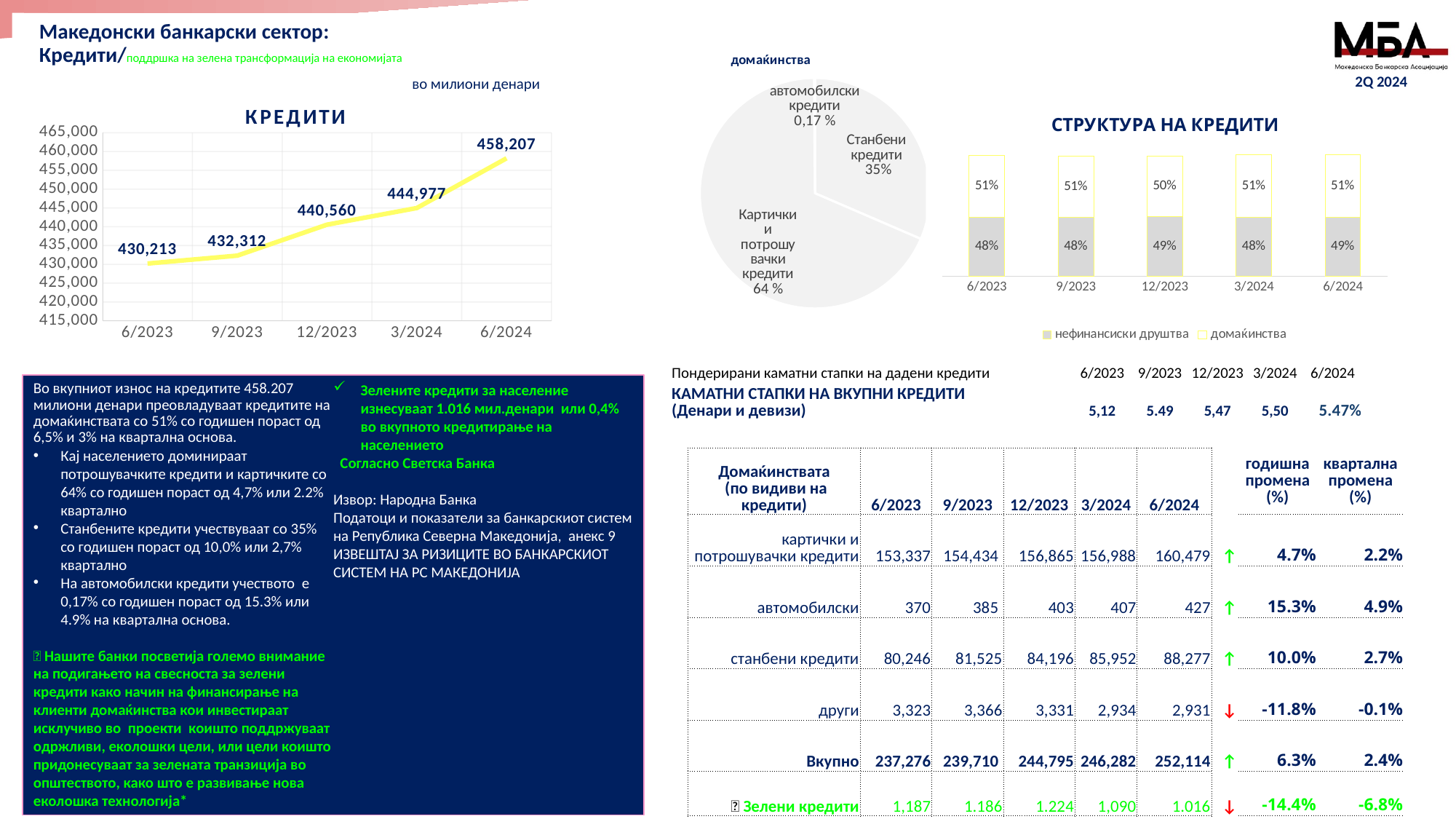
In the pie chart titled домаќинства, which category has the largest slice? Картички и потрошувачки кредити In the line chart titled КРЕДИТИ, how many data points are plotted? 5 What kind of chart is the chart titled КРЕДИТИ? line chart In the bar chart titled СТРУКТУРА НА КРЕДИТИ, what is the value for нефинансиски друштва in 12/2023? 49% In the line chart titled КРЕДИТИ, which period has the lowest value? 6/2023 In the pie chart titled домаќинства, what share do Станбени кредити have? 35% In the line chart titled КРЕДИТИ, what is the value for 12/2023? 440,560 In the bar chart titled СТРУКТУРА НА КРЕДИТИ, how many series does the legend list? 2 In the line chart titled КРЕДИТИ, what is the value for 6/2024? 458,207 In the line chart titled КРЕДИТИ, do the values rise or fall from 6/2023 to 6/2024? rise In the pie chart titled домаќинства, what is the share of автомобилски кредити? 0,17 % In the line chart titled КРЕДИТИ, what is the difference between the values for 6/2024 and 6/2023? 27,994